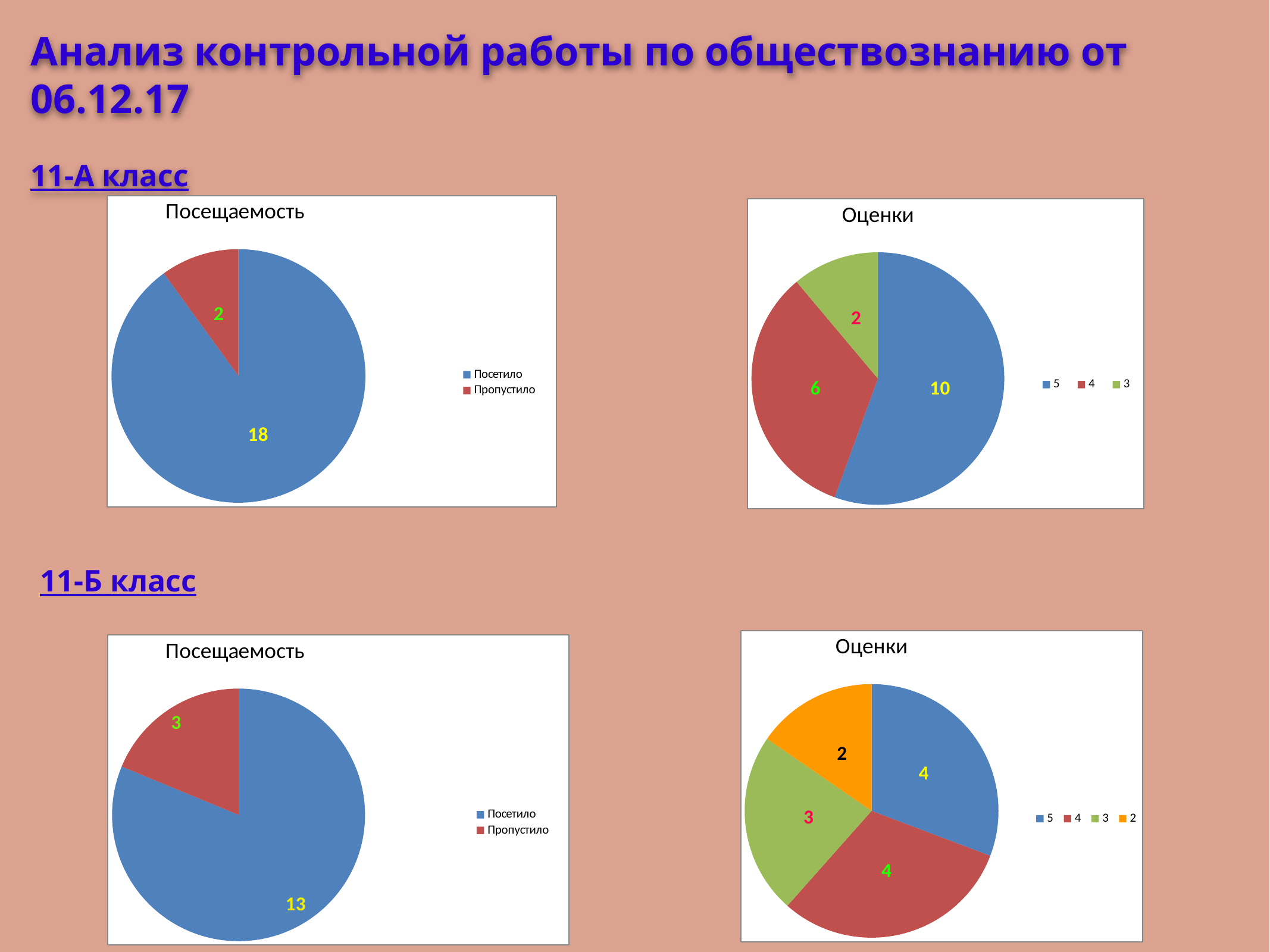
In the 11-А класс Оценки chart (top right), what is the difference between the values for grade 5 and grade 3? 8 In the 11-А класс Оценки chart (top right), which grade has the largest slice? 5 In the 11-Б класс Посещаемость chart (bottom left), what is the total of all slices? 16 In the 11-Б класс Оценки chart (bottom right), which grade has the smallest slice? 2 What type of chart is the 11-Б класс Посещаемость chart (bottom left)? pie chart In the 11-А класс Посещаемость chart (top left), what is the value for Пропустило? 2 In the 11-А класс Посещаемость chart (top left), what is the value for Посетило? 18 In the 11-А класс Оценки chart (top right), how many slices does the pie have? 3 In the 11-А класс Оценки chart (top right), what is the value for grade 4? 6 In the 11-Б класс Посещаемость chart (bottom left), what is the value for Пропустило? 3 In the 11-Б класс Оценки chart (bottom right), how many entries does the legend list? 4 In the 11-Б класс Оценки chart (bottom right), what is the value for grade 2? 2